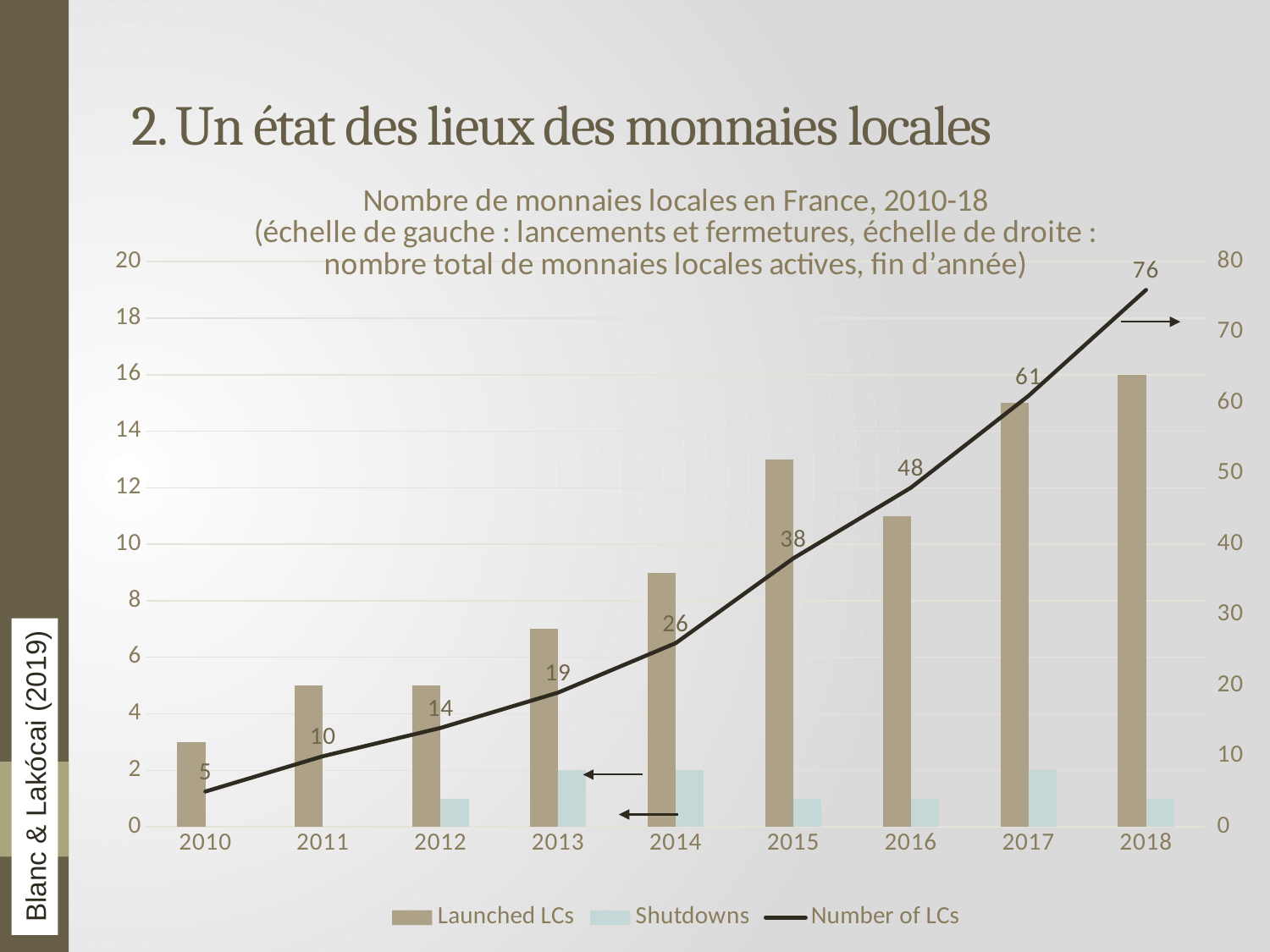
Does the Number of LCs line rise or fall from 2010 to 2018? rise What is the Number of LCs in 2010? 5 How many series does the legend list? 3 In which year is the Number of LCs highest? 2018 In which year is the Number of LCs lowest? 2010 How many years are shown on the x axis? 9 Is the value of Launched LCs in 2015 greater or less than 12? greater What is the Number of LCs in 2018? 76 By how much did the Number of LCs increase from 2017 to 2018? 15 How many Launched LCs are shown for 2018? 16 What is the Number of LCs in 2014? 26 Which year has more Launched LCs, 2015 or 2016? 2015